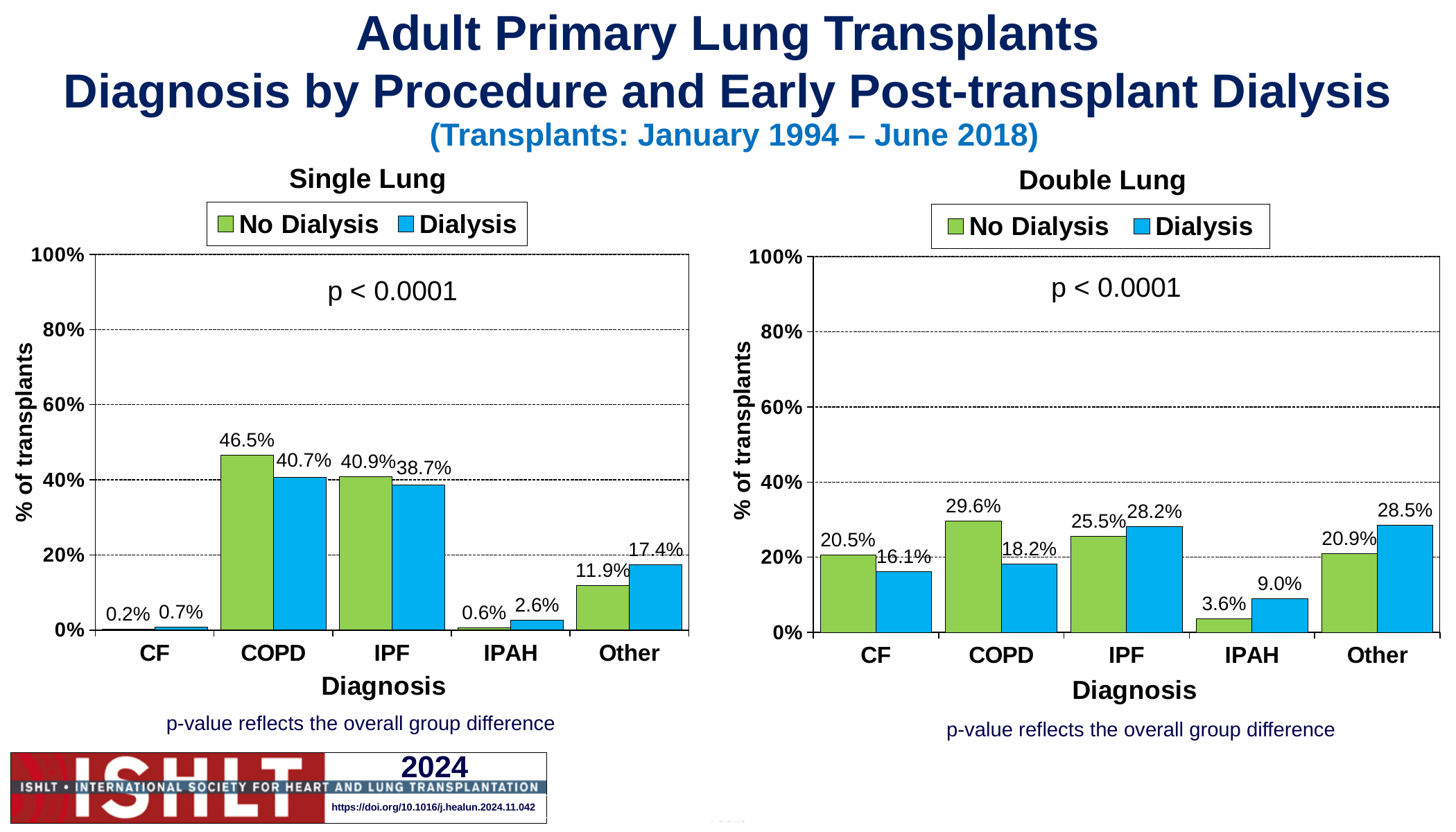
In the Double Lung chart, which is larger for IPF: the No Dialysis value or the Dialysis value? Dialysis In the Double Lung chart, what is the Dialysis value for Other? 28.5% What p-value is printed on the Single Lung chart? p < 0.0001 In the Single Lung chart, which diagnosis has the highest No Dialysis value? COPD In the Single Lung chart, what is the difference between the No Dialysis and Dialysis values for Other? 5.5% In the Double Lung chart, what is the difference between the No Dialysis and Dialysis values for CF? 4.4% What kind of chart is the Single Lung chart? Bar chart How many series does the legend of the Double Lung chart list? 2 How many diagnosis categories are shown on the x axis of the Single Lung chart? 5 In the Single Lung chart, what is the No Dialysis value for COPD? 46.5% In the Double Lung chart, is the No Dialysis value for COPD greater or less than 20%? greater In the Double Lung chart, which diagnosis has the lowest Dialysis value? IPAH